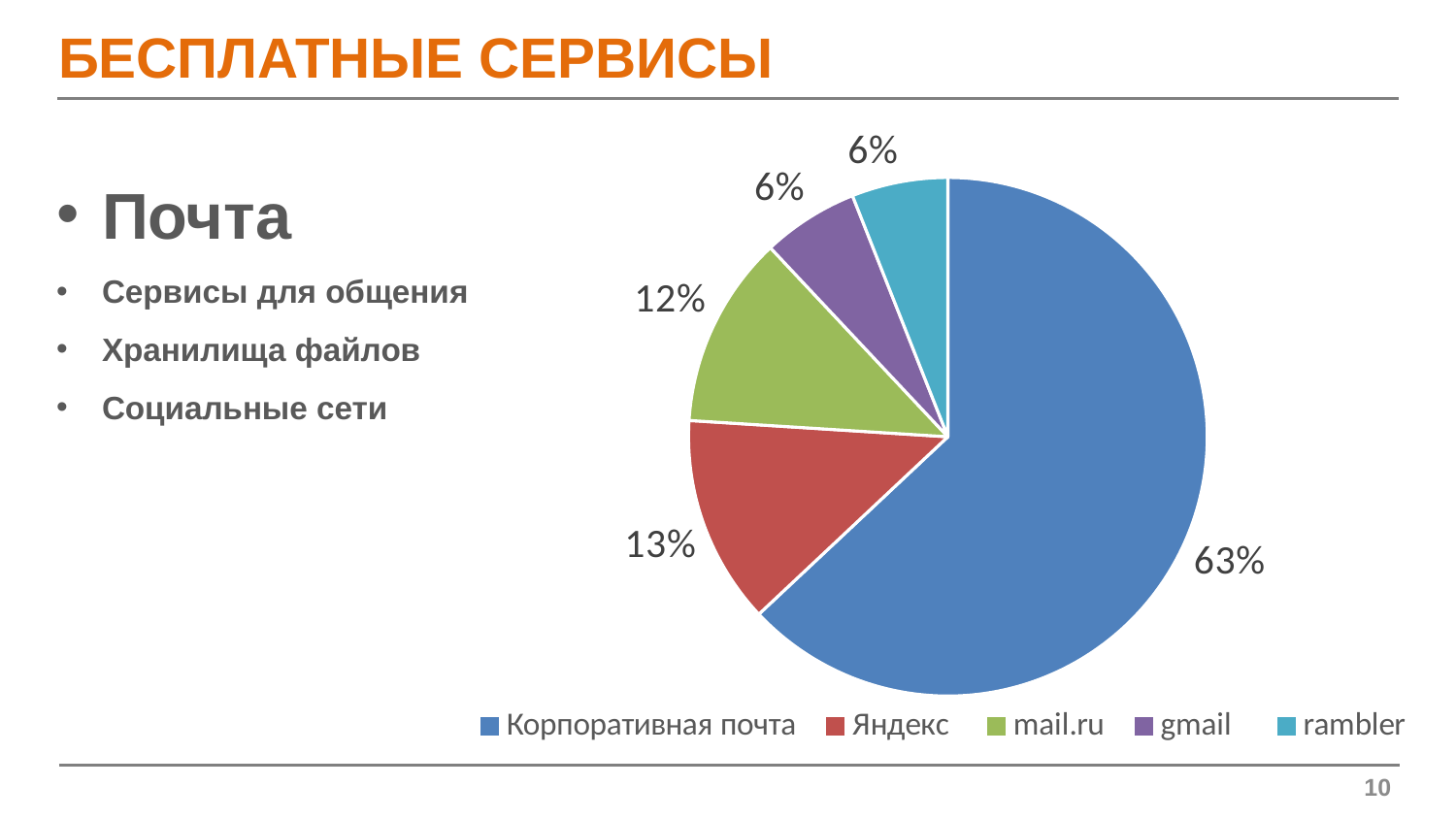
What share of the pie does rambler have? 6% How many slices does the pie chart have? 5 What share of the pie does gmail have? 6% What share of the pie does mail.ru have? 12% What colour is the slice for Корпоративная почта? blue Which is larger, the share for Яндекс or the share for mail.ru? Яндекс What is the difference in percentage points between mail.ru and gmail? 6 Which category has the largest slice of the pie? Корпоративная почта What is the difference in percentage points between Корпоративная почта and Яндекс? 50 What kind of chart is shown on the slide? pie chart